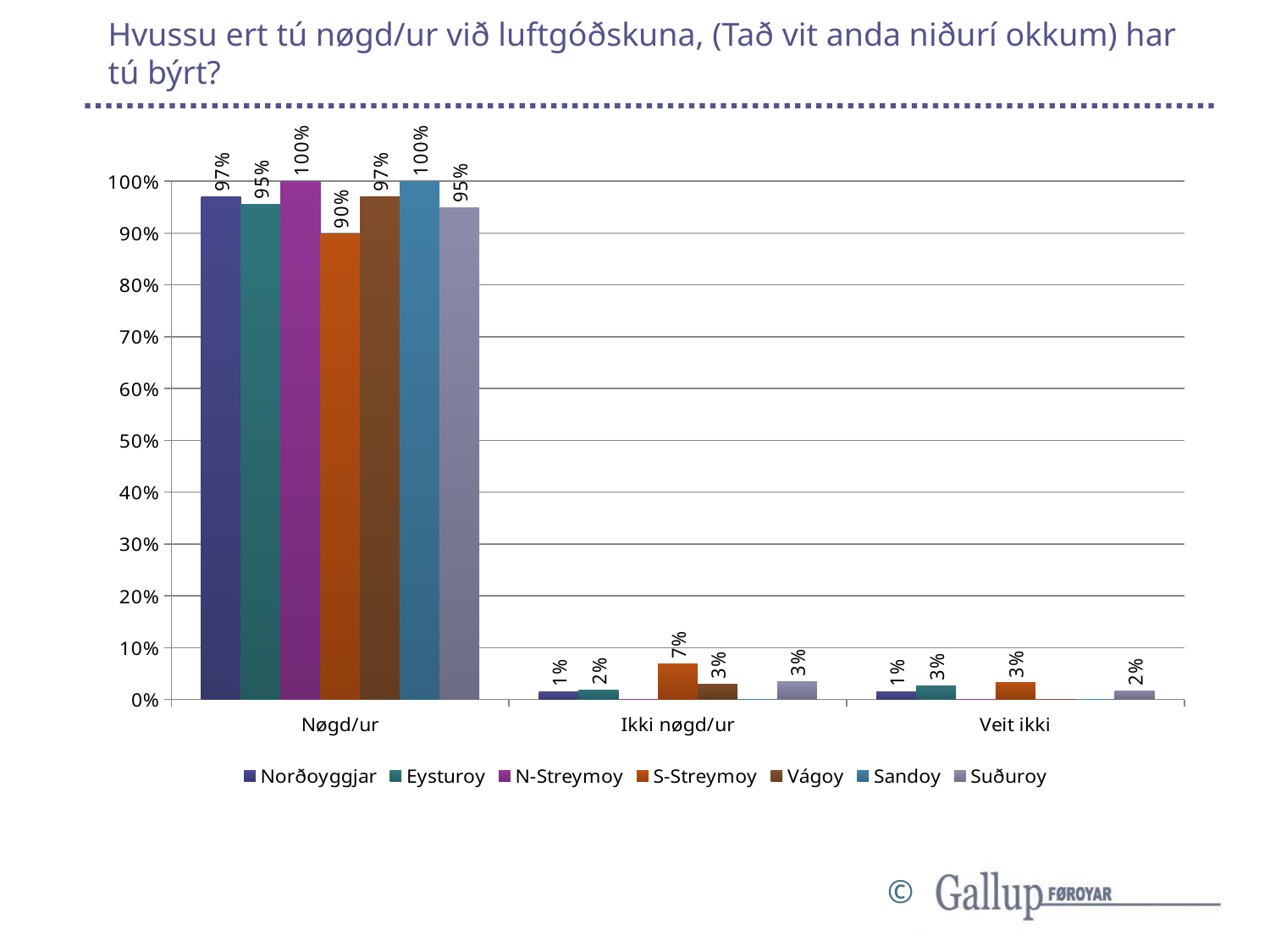
Which series has the lowest value in the Nøgd/ur category? S-Streymoy In the Nøgd/ur category, which is larger: Eysturoy or Vágoy? Vágoy What is the value for Suðuroy in the Veit ikki category? 2% Which series has the highest value in the Ikki nøgd/ur category? S-Streymoy How many categories are shown on the x axis? 3 How many series does the legend list? 7 What is the difference between N-Streymoy and S-Streymoy in the Nøgd/ur category? 10 percentage points What kind of chart is shown on the slide? bar chart What is the value for S-Streymoy in the Ikki nøgd/ur category? 7% What is the value for S-Streymoy in the Nøgd/ur category? 90% Is the value for Eysturoy in the Nøgd/ur category greater or less than 90%? greater Which series is listed first in the legend? Norðoyggjar